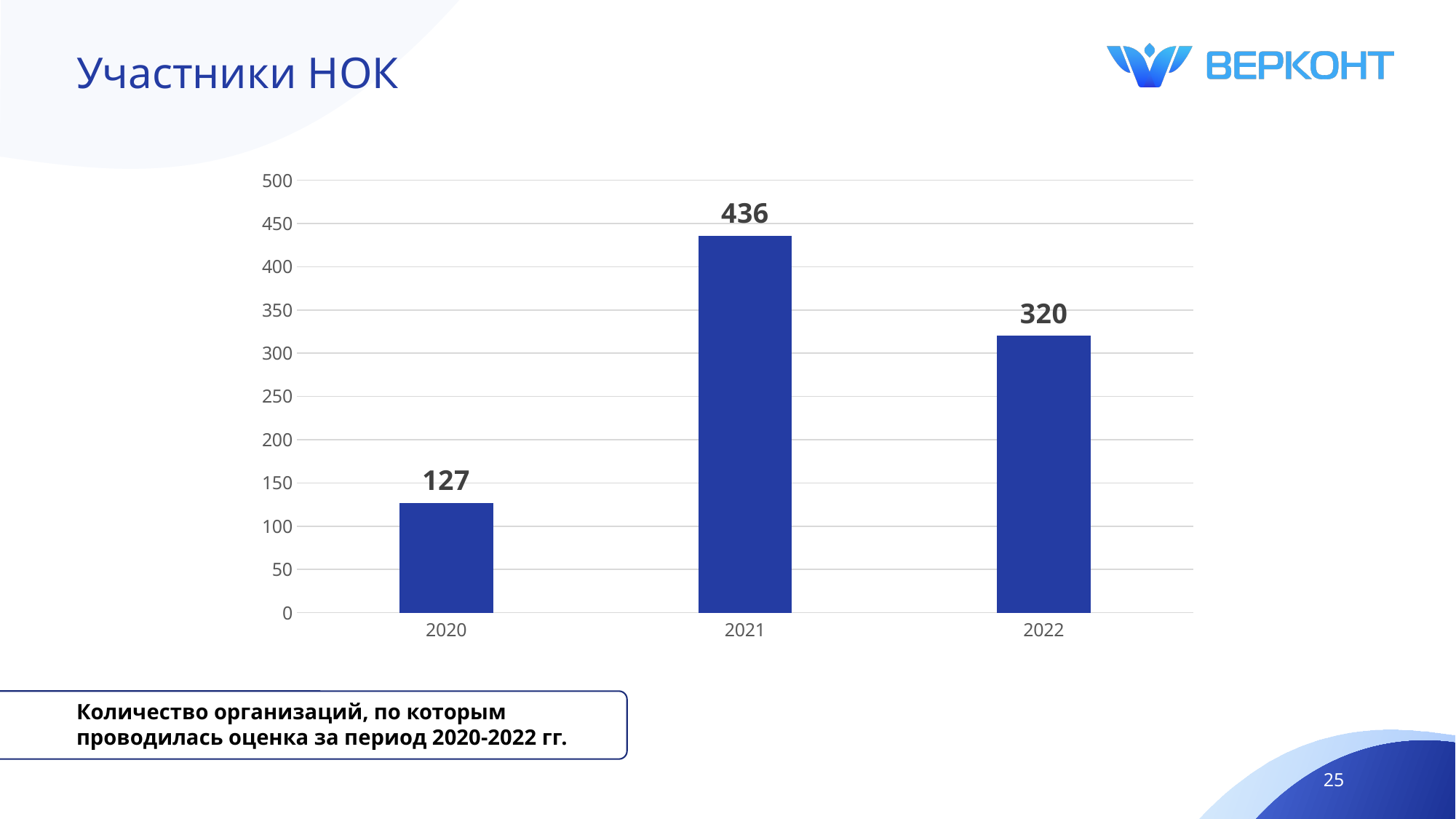
What is the value for 2022? 320 Which is larger, the value for 2020 or the value for 2022? 2022 What kind of chart is shown on the slide? bar chart What is the value for 2021? 436 Is the value for 2021 greater or less than 400? greater What is the difference between the values for 2022 and 2020? 193 What is the value for 2020? 127 Which year has the highest value? 2021 What is the difference between the values for 2021 and 2022? 116 Which year has the lowest value? 2020 How many years are shown on the x axis? 3 What is the title of the slide containing the chart? Участники НОК